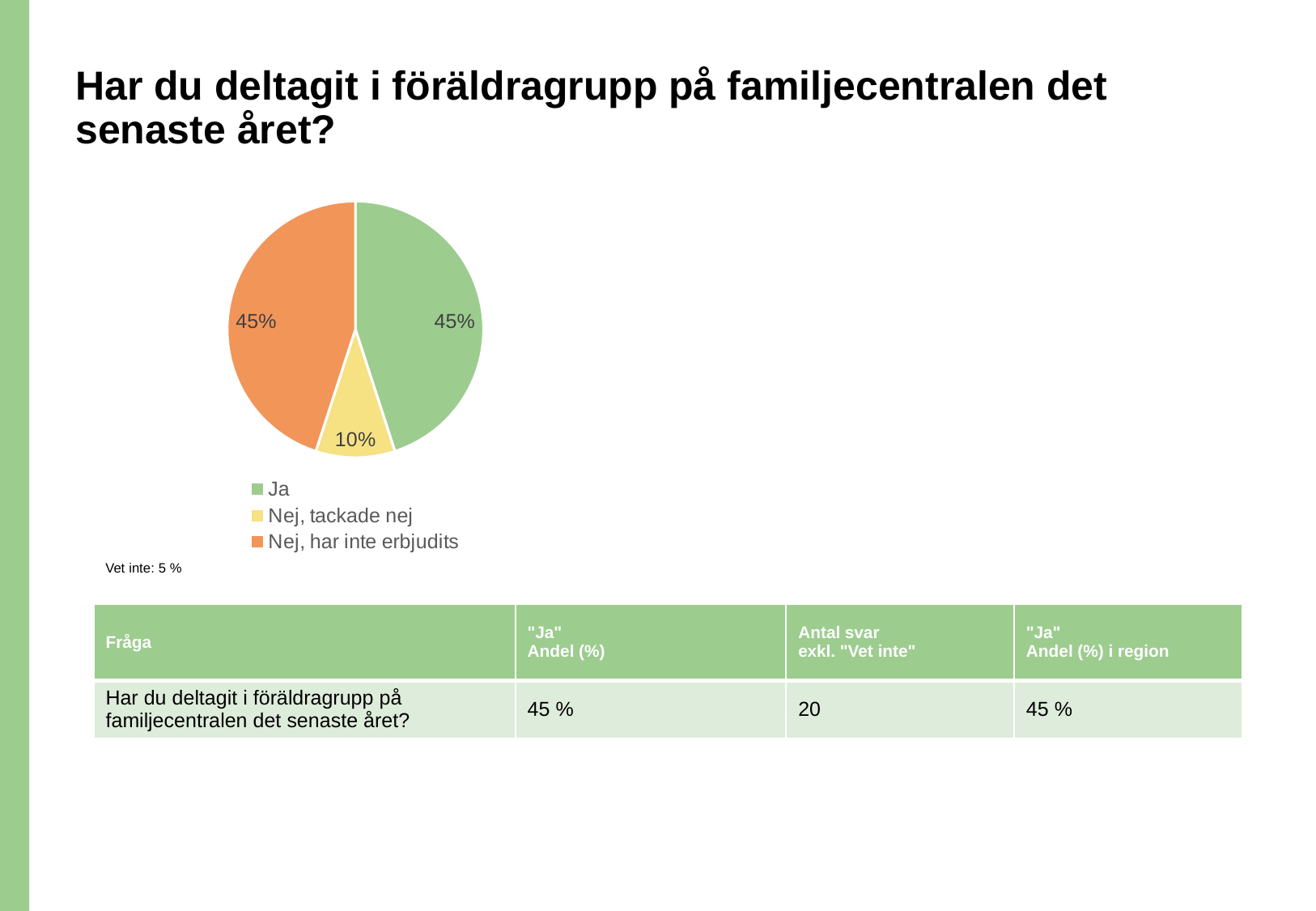
How many entries does the legend of the pie chart list? 3 What kind of chart is shown on the slide? Pie chart Which legend entry is shown in orange? Nej, har inte erbjudits What share of the pie does the "Nej, tackade nej" slice represent? 10% How many slices does the pie chart have? 3 What colour is the "Ja" slice in the pie chart? Green Is the value for "Nej, tackade nej" greater or less than 20%? less What is the difference in percentage points between the "Ja" slice and the "Nej, tackade nej" slice? 35 percentage points What share of the pie does the "Nej, har inte erbjudits" slice represent? 45% Which category has the smallest slice of the pie? Nej, tackade nej Which is larger, the "Ja" slice or the "Nej, tackade nej" slice? Ja What share of the pie does the "Ja" slice represent? 45%